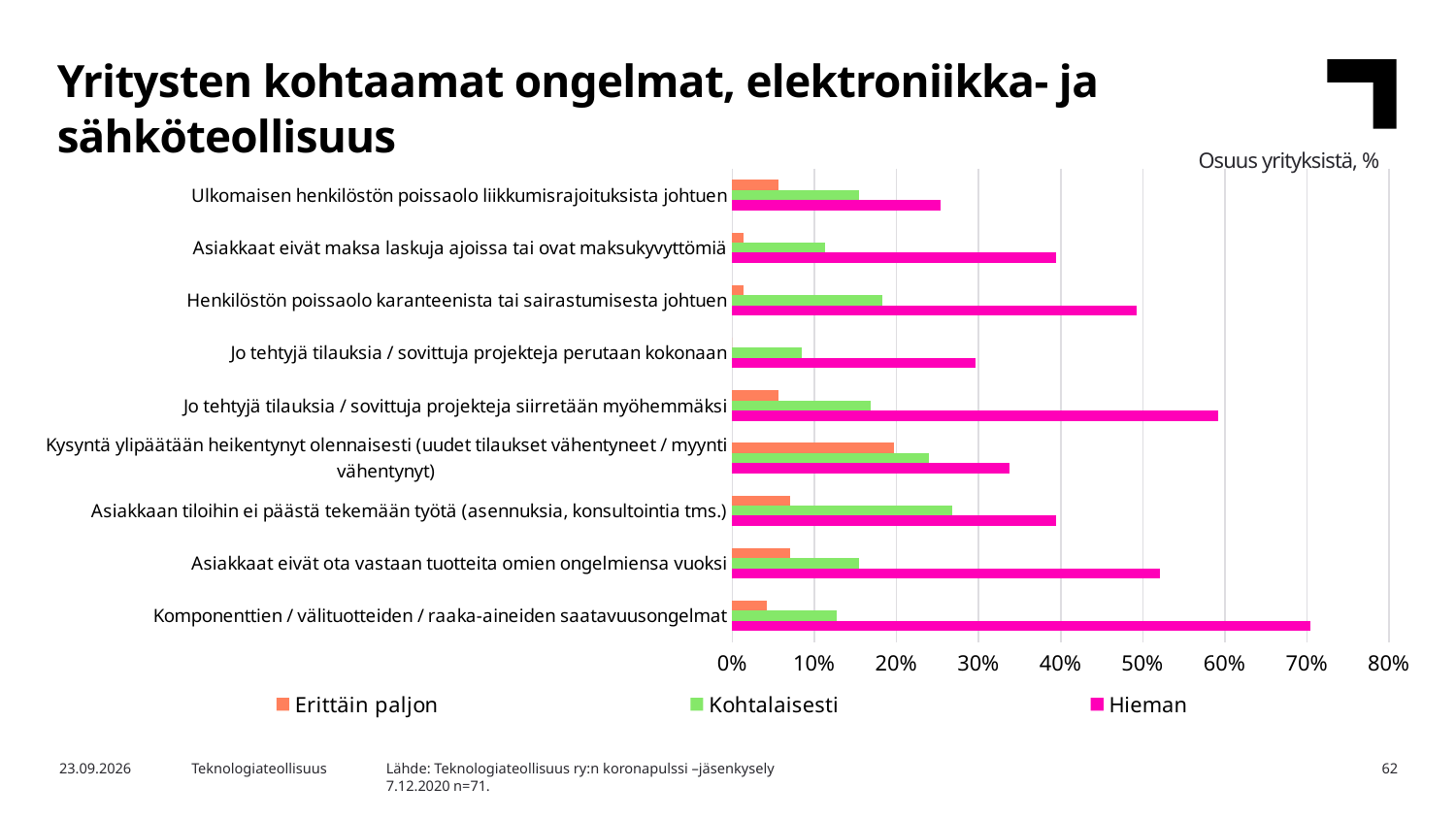
Which is larger: the 'Hieman' value for 'Asiakkaat eivät ota vastaan tuotteita omien ongelmiensa vuoksi' or for 'Asiakkaat eivät maksa laskuja ajoissa tai ovat maksukyvyttömiä'? Asiakkaat eivät ota vastaan tuotteita omien ongelmiensa vuoksi What label is shown above the chart describing the measured quantity? Osuus yrityksistä, % Which category has the highest value for the 'Hieman' series? Komponenttien / välituotteiden / raaka-aineiden saatavuusongelmat Is the 'Hieman' value for 'Komponenttien / välituotteiden / raaka-aineiden saatavuusongelmat' greater or less than 60%? greater How many series does the legend list? 3 How many categories (problems) are plotted on the chart? 9 Which category has the highest value for the 'Erittäin paljon' series? Kysyntä ylipäätään heikentynyt olennaisesti (uudet tilaukset vähentyneet / myynti vähentynyt) Is the 'Kohtalaisesti' value for 'Asiakkaat eivät maksa laskuja ajoissa tai ovat maksukyvyttömiä' greater or less than 20%? less Which is larger: the 'Kohtalaisesti' value for 'Henkilöstön poissaolo karanteenista tai sairastumisesta johtuen' or for 'Asiakkaat eivät maksa laskuja ajoissa tai ovat maksukyvyttömiä'? Henkilöstön poissaolo karanteenista tai sairastumisesta johtuen Is the 'Hieman' value for 'Jo tehtyjä tilauksia / sovittuja projekteja siirretään myöhemmäksi' greater or less than 50%? greater What kind of chart is shown on the slide? Bar chart